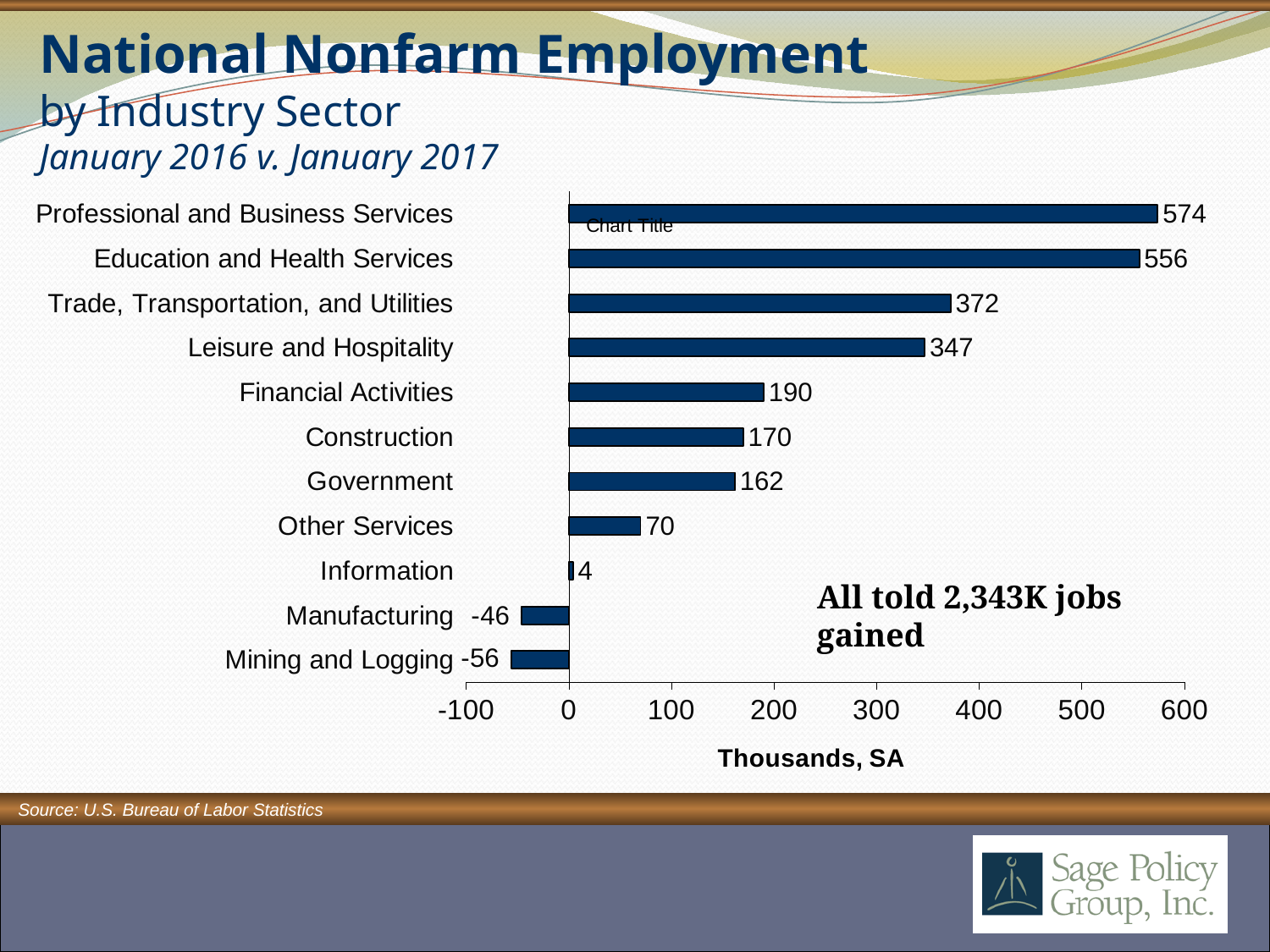
Which industry sector has the lowest value? Mining and Logging What is the label of the horizontal axis? Thousands, SA Which is larger, the value for Construction or the value for Government? Construction What is the difference between the values for Professional and Business Services and Education and Health Services? 18 What is the value for Mining and Logging? -56 How many industry sectors are shown in the chart? 11 What is the value for Professional and Business Services? 574 What is the value for Government? 162 Is the value for Financial Activities greater or less than 200? less Which industry sector has the highest value? Professional and Business Services What is the difference between the values for Trade, Transportation, and Utilities and Leisure and Hospitality? 25 What kind of chart is shown on the slide? bar chart